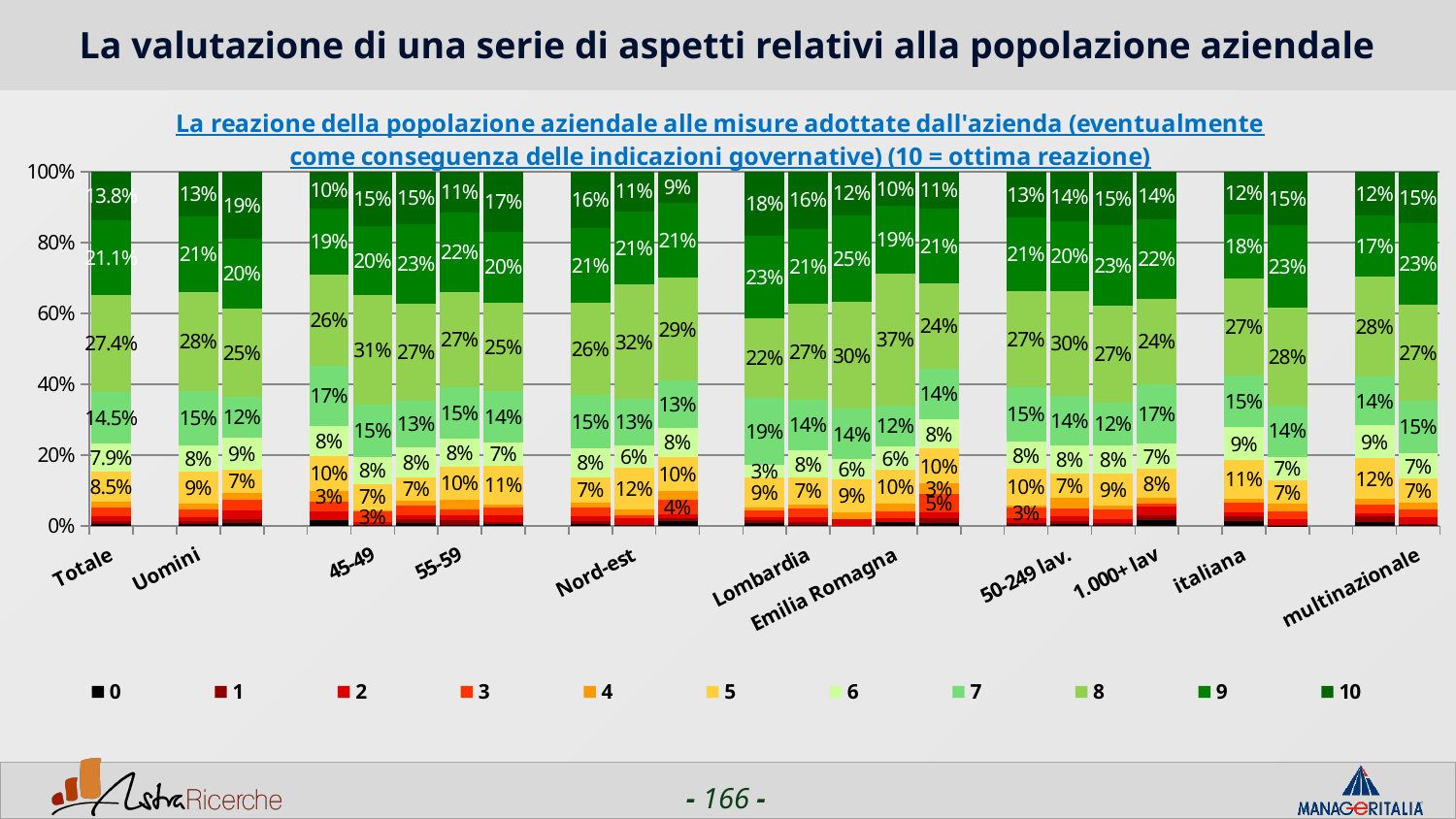
In the Totale bar, which has the larger share: score 9 or score 7? Score 9 In the Totale bar, what is the difference between the share of score 8 and the share of score 7? 12.9 percentage points What is the share of score 8 in the Uomini bar? 28% What is the share of score 10 in the Totale bar? 13.8% What is the share of score 10 in the Uomini bar? 13% According to the chart title, what does a score of 10 represent? Ottima reazione In the Uomini bar, what is the difference between the share of score 8 and the share of score 9? 7 percentage points What is the share of score 8 in the Totale bar? 27.4% In the Totale bar, which score has the largest share? 8 How many series does the legend list? 11 What is the share of score 5 in the Totale bar? 8.5% What type of chart is shown on the slide? Stacked bar chart